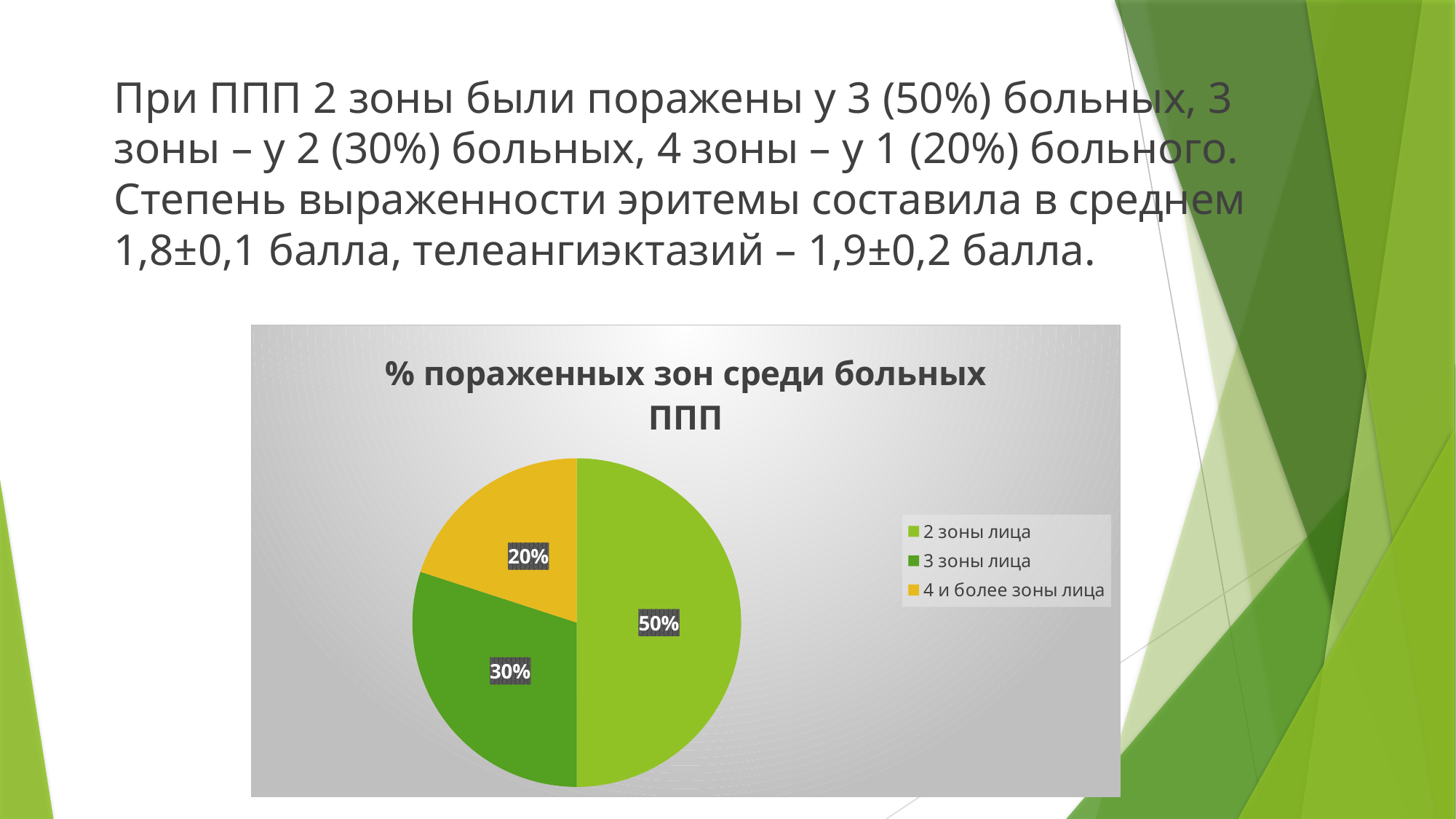
What colour is the slice for "4 и более зоны лица"? yellow Which category has the smallest slice of the pie? 4 и более зоны лица What share of the pie is labelled for "2 зоны лица"? 50% What is the difference in percentage points between the slices for "2 зоны лица" and "3 зоны лица"? 20 What share of the pie is labelled for "3 зоны лица"? 30% Which category has the largest slice of the pie? 2 зоны лица Which slice is larger: "3 зоны лица" or "4 и более зоны лица"? 3 зоны лица What share of the pie is labelled for "4 и более зоны лица"? 20% How many slices does the pie chart have? 3 What is the title of the chart? % пораженных зон среди больных ППП What kind of chart is shown on the slide? pie chart How many entries does the legend list? 3